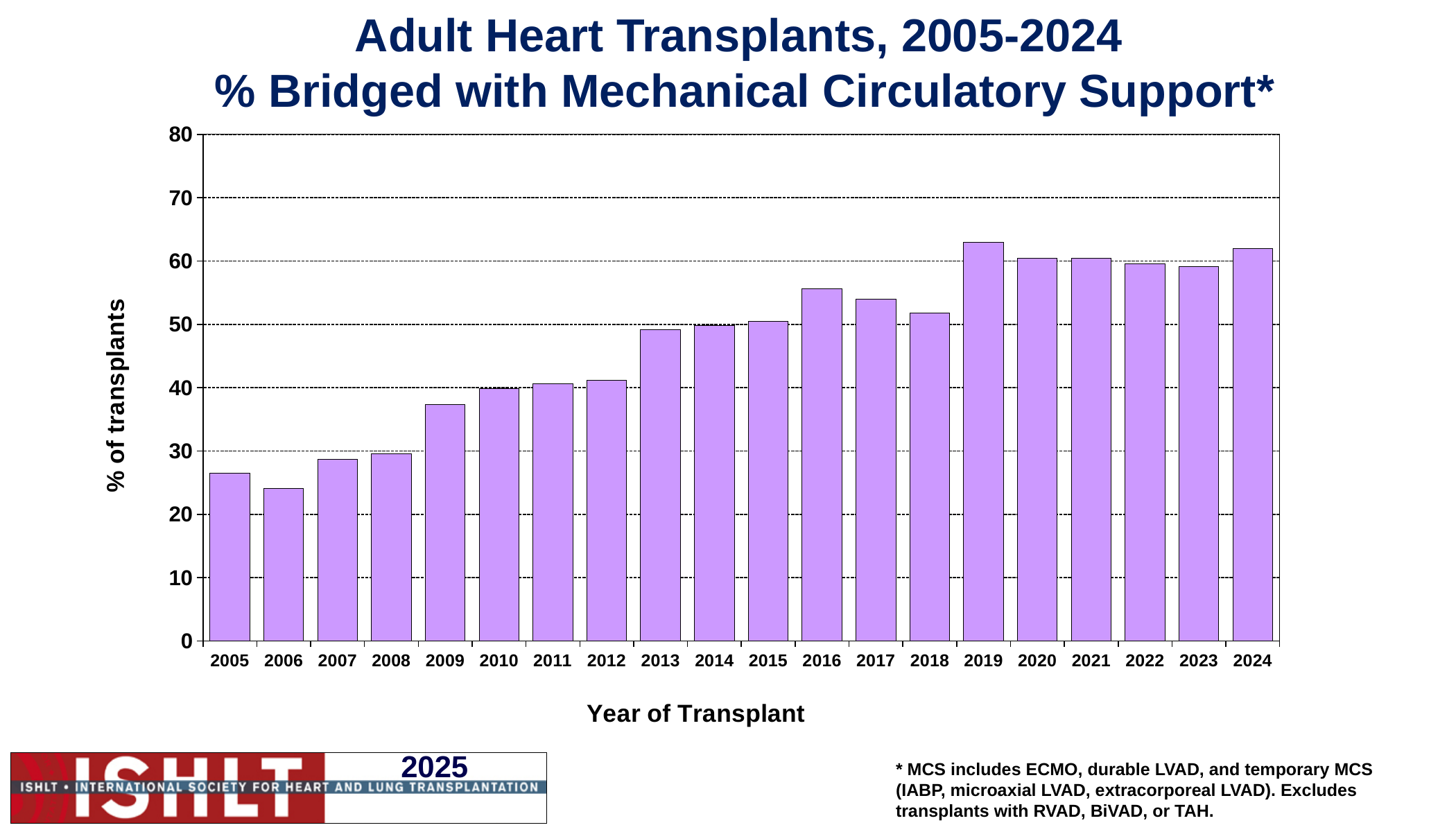
Is the value for 2006 greater or less than 20? greater Which year has a higher value, 2016 or 2018? 2016 What kind of chart is shown on the slide? bar chart Is the value for 2016 greater or less than 50? greater Is the value for 2005 greater or less than 30? less Overall, do the values rise or fall from 2005 to 2024? rise How many years are plotted on the x axis? 20 What is the label on the y axis? % of transplants Which year has the lowest % of transplants bridged with mechanical circulatory support? 2006 Which year has the highest % of transplants bridged with mechanical circulatory support? 2019